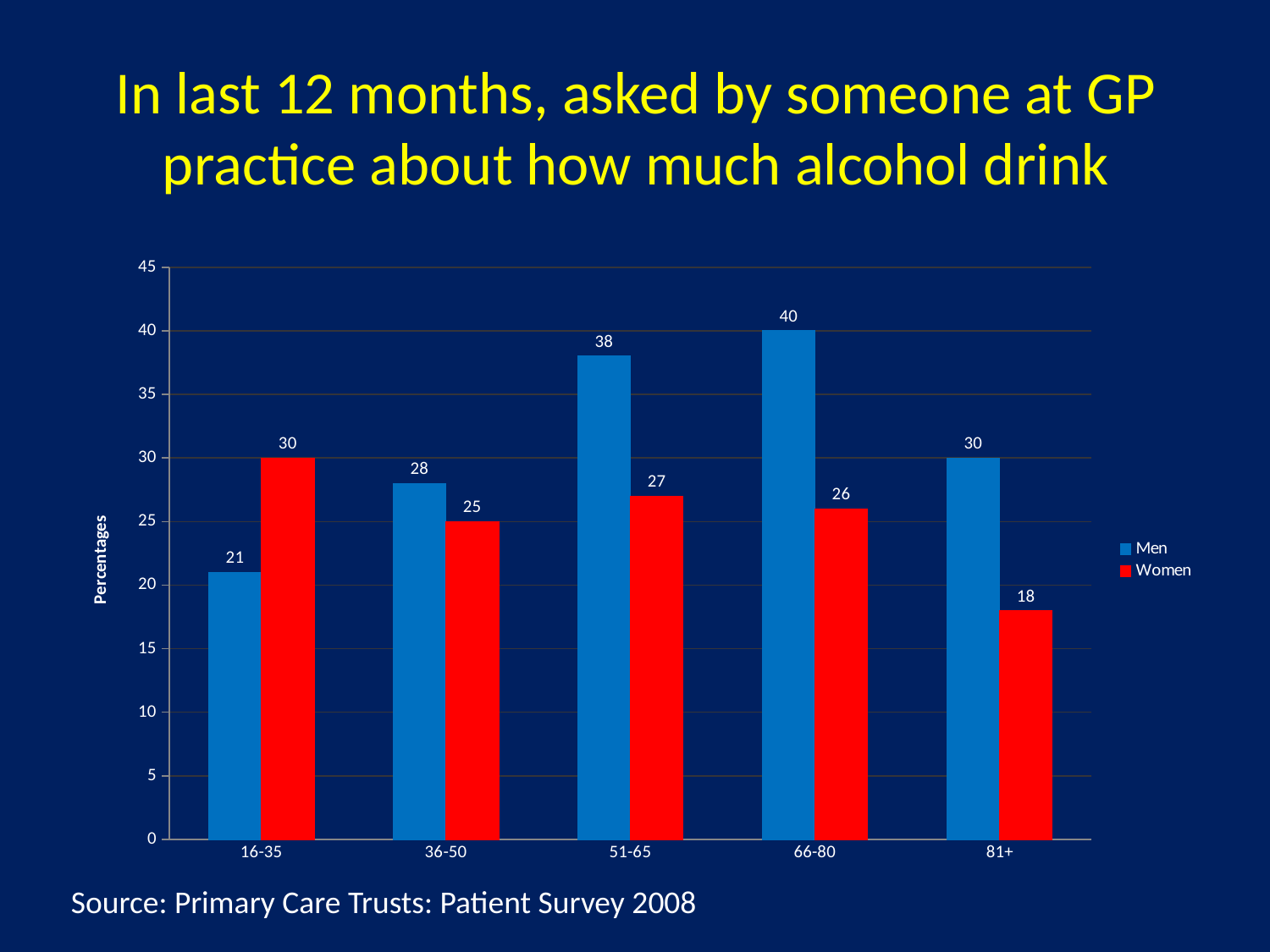
What is the value for Men in the 66-80 age group? 40 How many series does the legend list? 2 In the 16-35 age group, which is larger, the value for Men or for Women? Women What is the value for Women in the 16-35 age group? 30 Which age group has the highest value for Men? 66-80 Is the value for Men in the 36-50 age group greater or less than 25? greater What kind of chart is shown on the slide? Bar chart How many age groups are shown on the x axis? 5 What is the difference between the Men and Women values in the 51-65 age group? 11 Which age group has the lowest value for Women? 81+ What is the value for Women in the 81+ age group? 18 What is the label on the vertical axis? Percentages